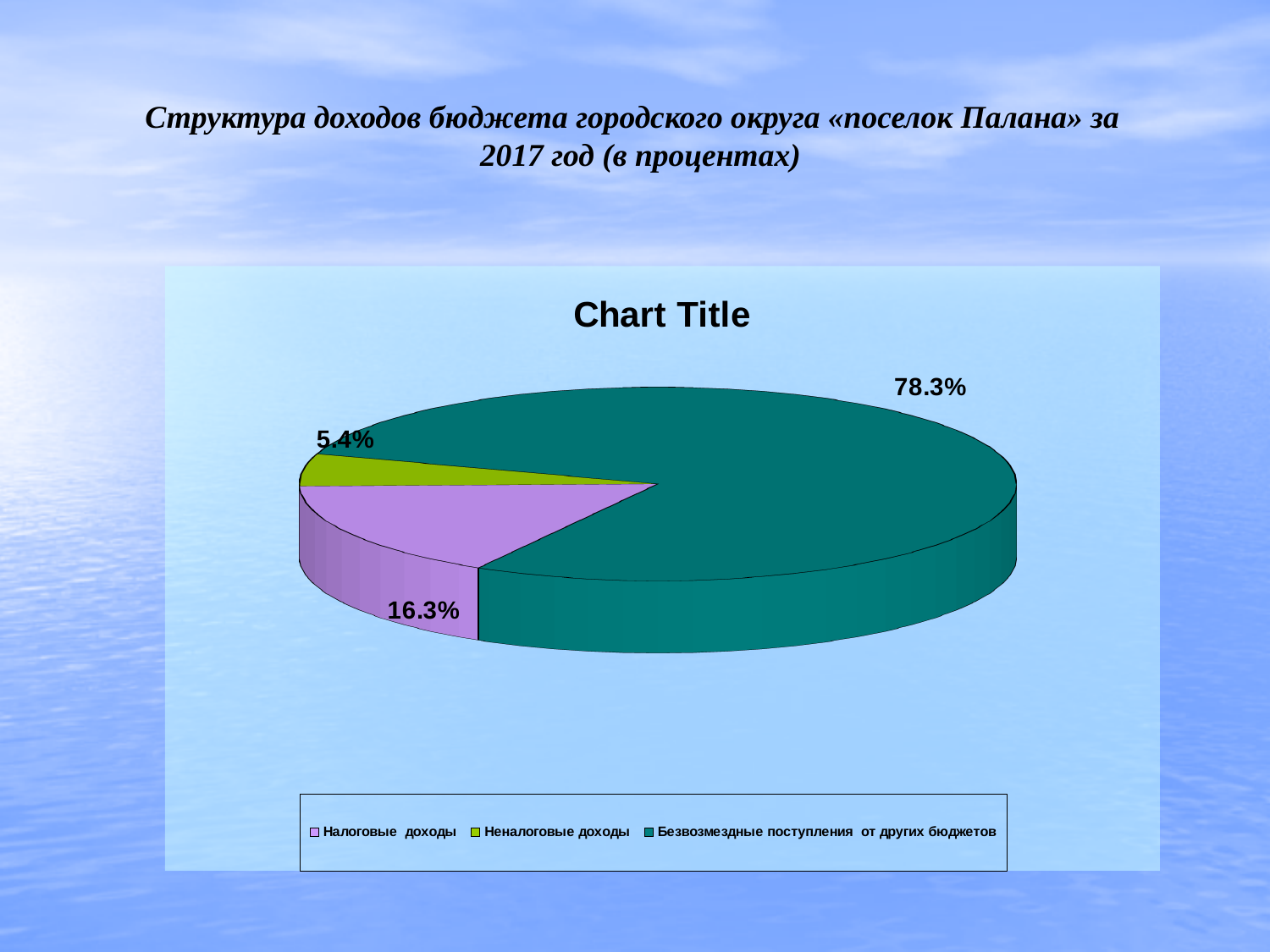
What share of the pie does Безвозмездные поступления от других бюджетов have? 78.3% What colour is the slice for Налоговые доходы? purple How many categories does the pie chart have? 3 What is the difference between the shares of Налоговые доходы and Неналоговые доходы? 10.9 percentage points Which category has the smallest slice of the pie? Неналоговые доходы What share of the pie does Налоговые доходы have? 16.3% Which category has the largest slice of the pie? Безвозмездные поступления от других бюджетов Which is larger, the share of Налоговые доходы or the share of Неналоговые доходы? Налоговые доходы What kind of chart is shown on the slide? pie chart What is the difference between the shares of Безвозмездные поступления от других бюджетов and Налоговые доходы? 62.0 percentage points What is the title shown inside the chart area? Chart Title What share of the pie does Неналоговые доходы have? 5.4%